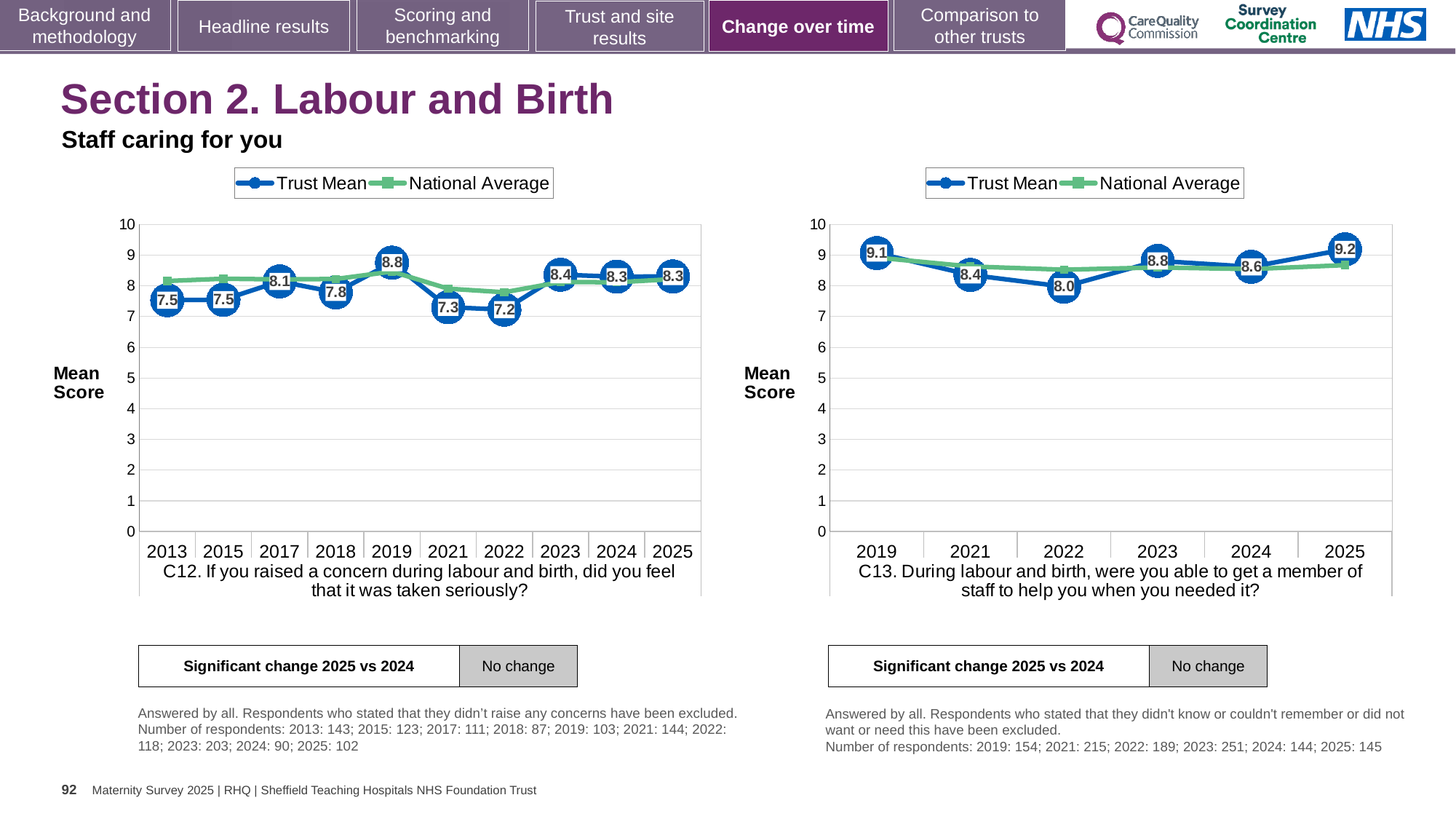
On the left chart (C12), which year has the highest Trust Mean? 2019 On the left chart (C12), what is the Trust Mean for 2019? 8.8 On the right chart (C13), is the Trust Mean for 2021 or for 2023 larger? 2023 On the right chart (C13), is the National Average for 2019 greater or less than 8? greater On the right chart (C13), which year has the lowest Trust Mean? 2022 On the right chart (C13), what is the Trust Mean for 2025? 9.2 On the left chart (C12), which year has the lowest Trust Mean? 2022 What kind of chart is the left chart (C12)? Line chart On the left chart (C12), how many years are plotted on the x axis? 10 On the left chart (C12), what is the Trust Mean for 2022? 7.2 How many series does the legend of the right chart (C13) list? 2 On the left chart (C12), what is the difference between the Trust Mean in 2019 and in 2022? 1.6